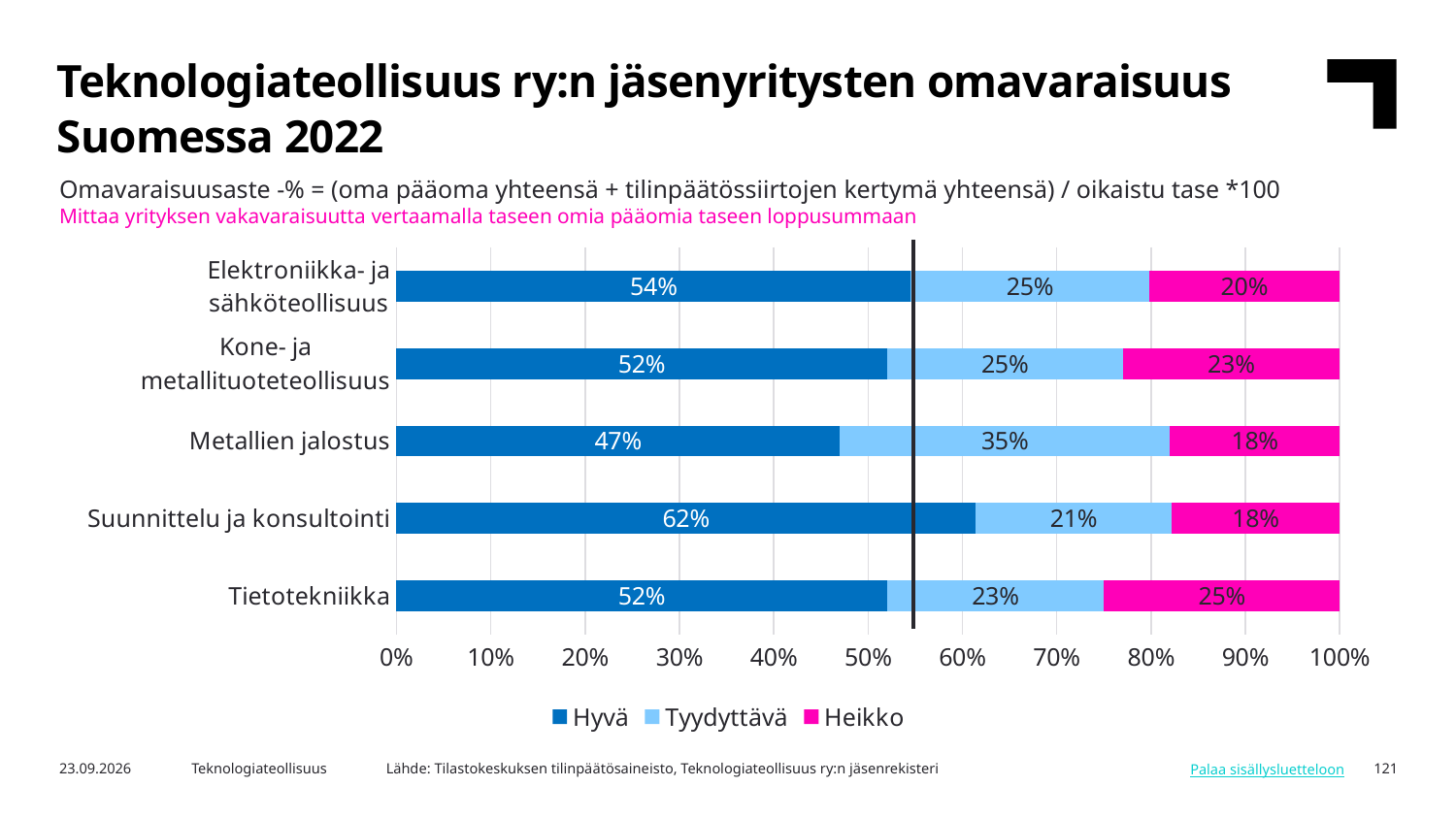
How many series does the legend list? 3 Which category has the lowest Hyvä value? Metallien jalostus Which category has the highest Hyvä value? Suunnittelu ja konsultointi How many categories are shown in the chart? 5 Which is larger, the Heikko value for Kone- ja metallituoteteollisuus or the Heikko value for Metallien jalostus? Kone- ja metallituoteteollisuus What is the Hyvä value for Elektroniikka- ja sähköteollisuus? 54% Which series is shown in magenta in the legend? Heikko What kind of chart is shown on the slide? Stacked bar chart What is the difference between the Hyvä values for Suunnittelu ja konsultointi and Metallien jalostus? 15% What is the Tyydyttävä value for Metallien jalostus? 35% What is the Heikko value for Tietotekniikka? 25% What is the Hyvä value for Suunnittelu ja konsultointi? 62%